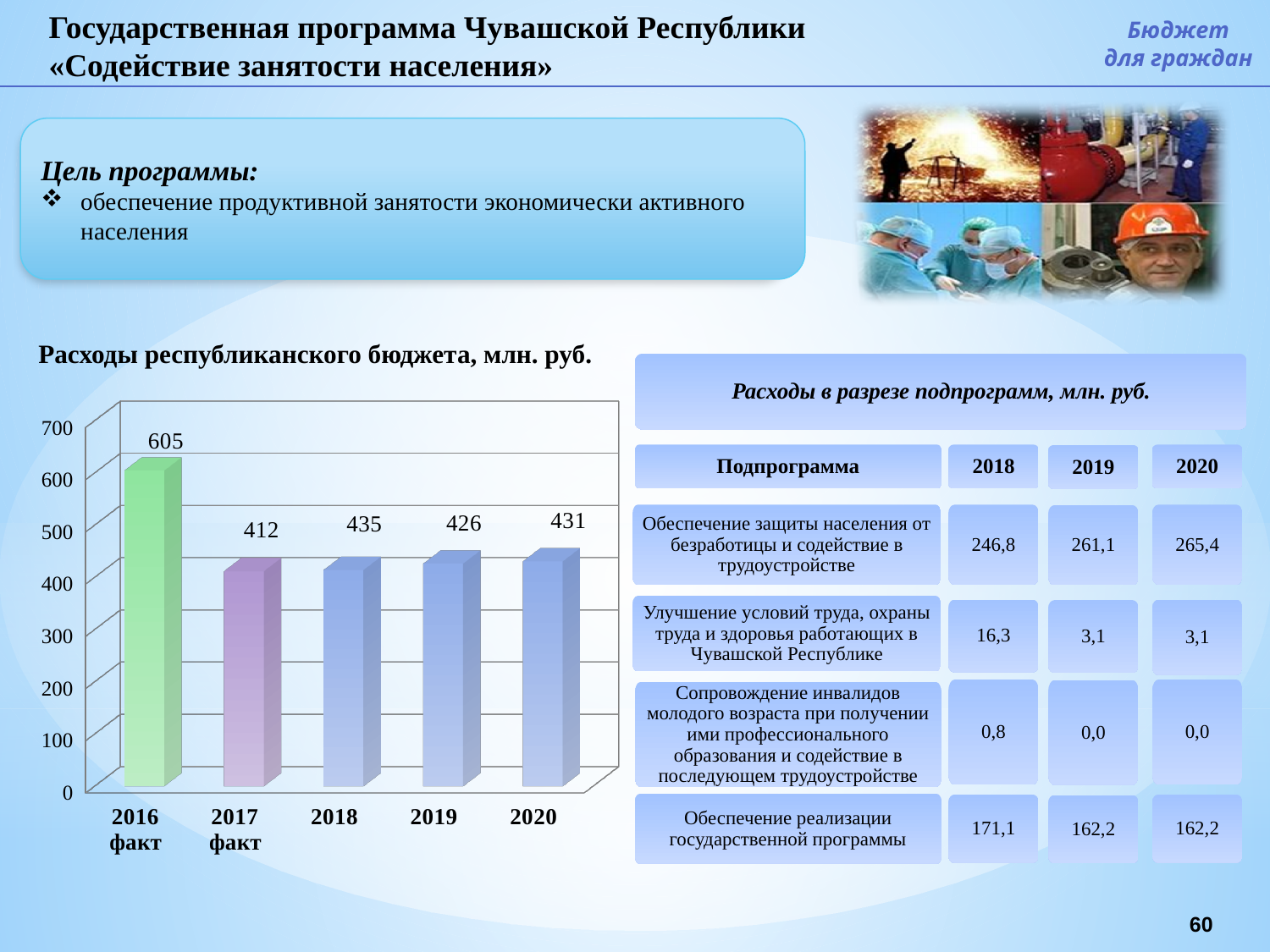
What is the value for 2016 факт in the chart 'Расходы республиканского бюджета, млн. руб.'? 605 What is the difference between the values for 2016 факт and 2017 факт in the chart 'Расходы республиканского бюджета, млн. руб.'? 193 Which year has the lowest value in the chart 'Расходы республиканского бюджета, млн. руб.'? 2017 факт What is the value for 2018 in the chart 'Расходы республиканского бюджета, млн. руб.'? 435 What is the value for 2020 in the chart 'Расходы республиканского бюджета, млн. руб.'? 431 Is the value for 2017 факт greater or less than 500 in the chart 'Расходы республиканского бюджета, млн. руб.'? less Which year has the highest value in the chart 'Расходы республиканского бюджета, млн. руб.'? 2016 факт What is the difference between the values for 2018 and 2019 in the chart 'Расходы республиканского бюджета, млн. руб.'? 9 How many years are shown on the x axis of the chart 'Расходы республиканского бюджета, млн. руб.'? 5 What kind of chart is 'Расходы республиканского бюджета, млн. руб.'? bar chart Which is larger in the chart 'Расходы республиканского бюджета, млн. руб.': the value for 2018 or the value for 2020? 2018 What is the title of the chart on the left side of the slide? Расходы республиканского бюджета, млн. руб.